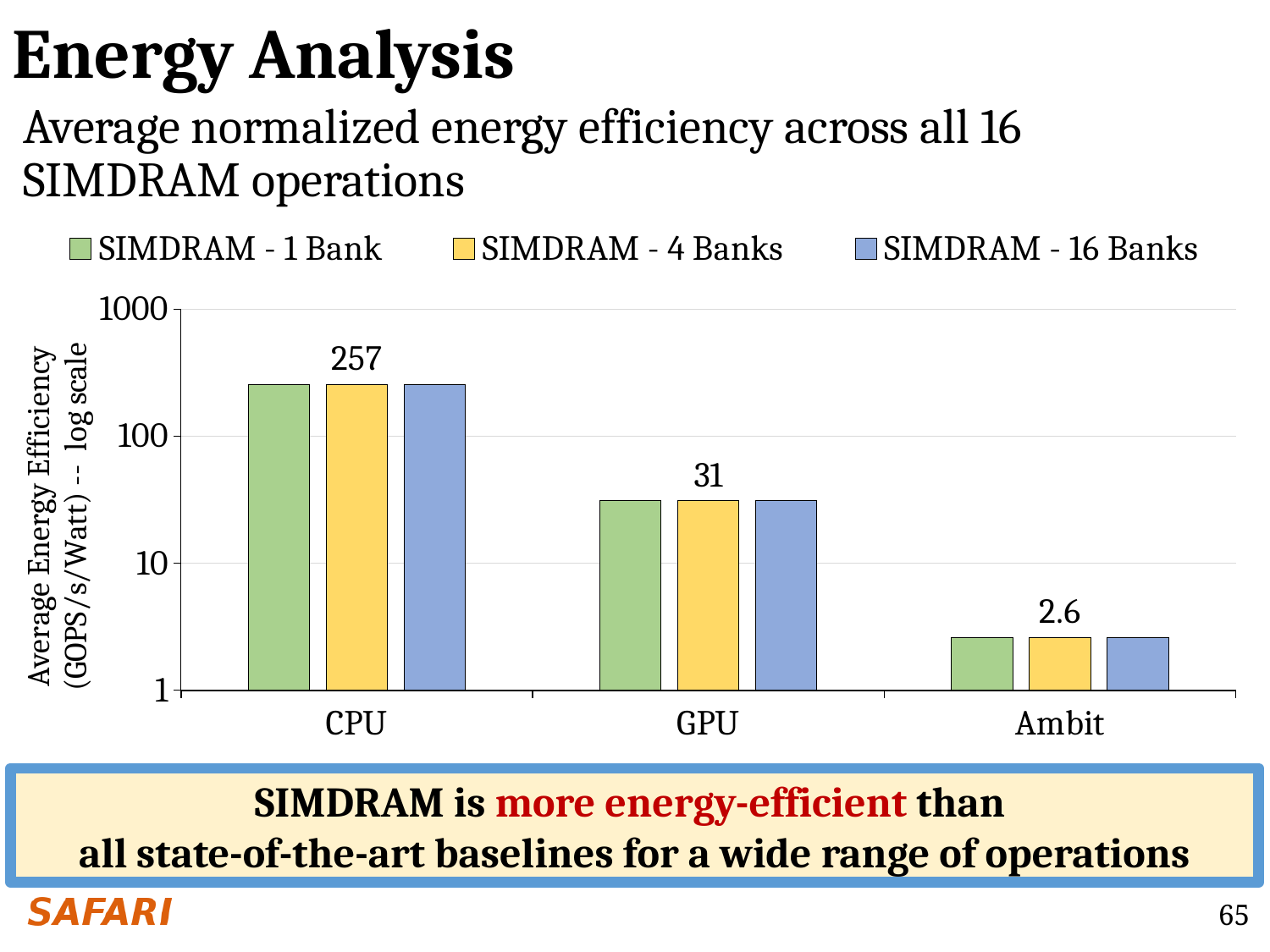
What is the difference between the labeled SIMDRAM - 4 Banks values for CPU and GPU? 226 Which category has the lowest average energy efficiency? Ambit How many categories are shown on the x axis? 3 What value is labeled for SIMDRAM - 4 Banks in the GPU group? 31 Which is larger, the SIMDRAM - 4 Banks value for GPU or for Ambit? GPU Do the values rise or fall moving from CPU to Ambit along the x axis? fall How many series does the legend list? 3 What value is labeled for SIMDRAM - 4 Banks in the CPU group? 257 Which category has the highest average energy efficiency? CPU What value is labeled for SIMDRAM - 4 Banks in the Ambit group? 2.6 What kind of chart is shown on the slide? bar chart Is the value for SIMDRAM - 1 Bank in the CPU group greater or less than 100? greater